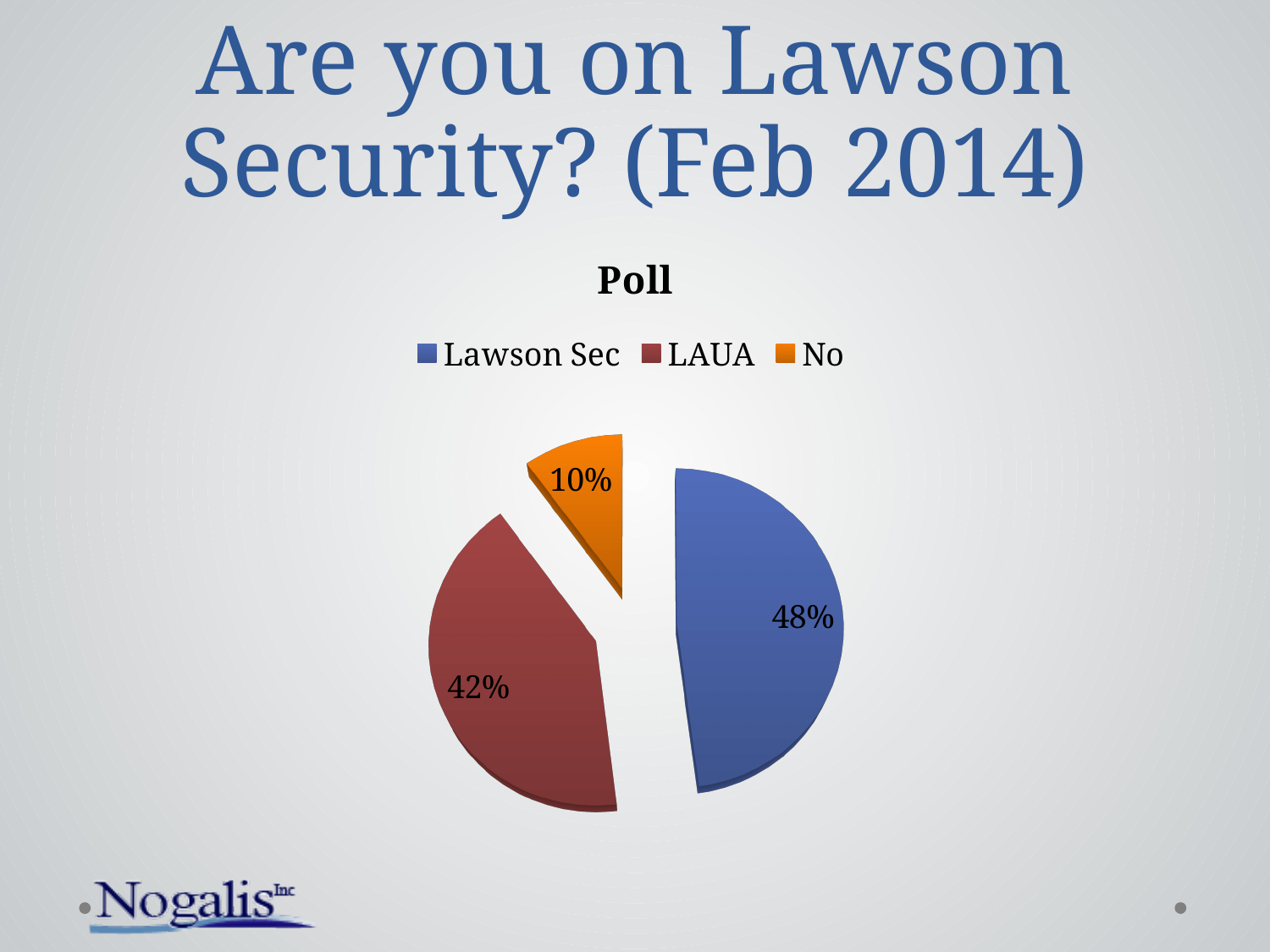
What share of the pie does Lawson Sec hold? 48% How many slices does the pie chart have? 3 Which category has the smallest slice of the pie? No What share of the pie does LAUA hold? 42% Which category has the largest slice of the pie? Lawson Sec What share of the pie does No hold? 10% What is the difference in percentage points between the Lawson Sec and LAUA slices? 6 What is the difference in percentage points between the LAUA and No slices? 32 How many entries does the legend list? 3 What kind of chart is shown on the slide? Pie chart Which is larger, the LAUA slice or the No slice? LAUA What is the title of the chart? Poll